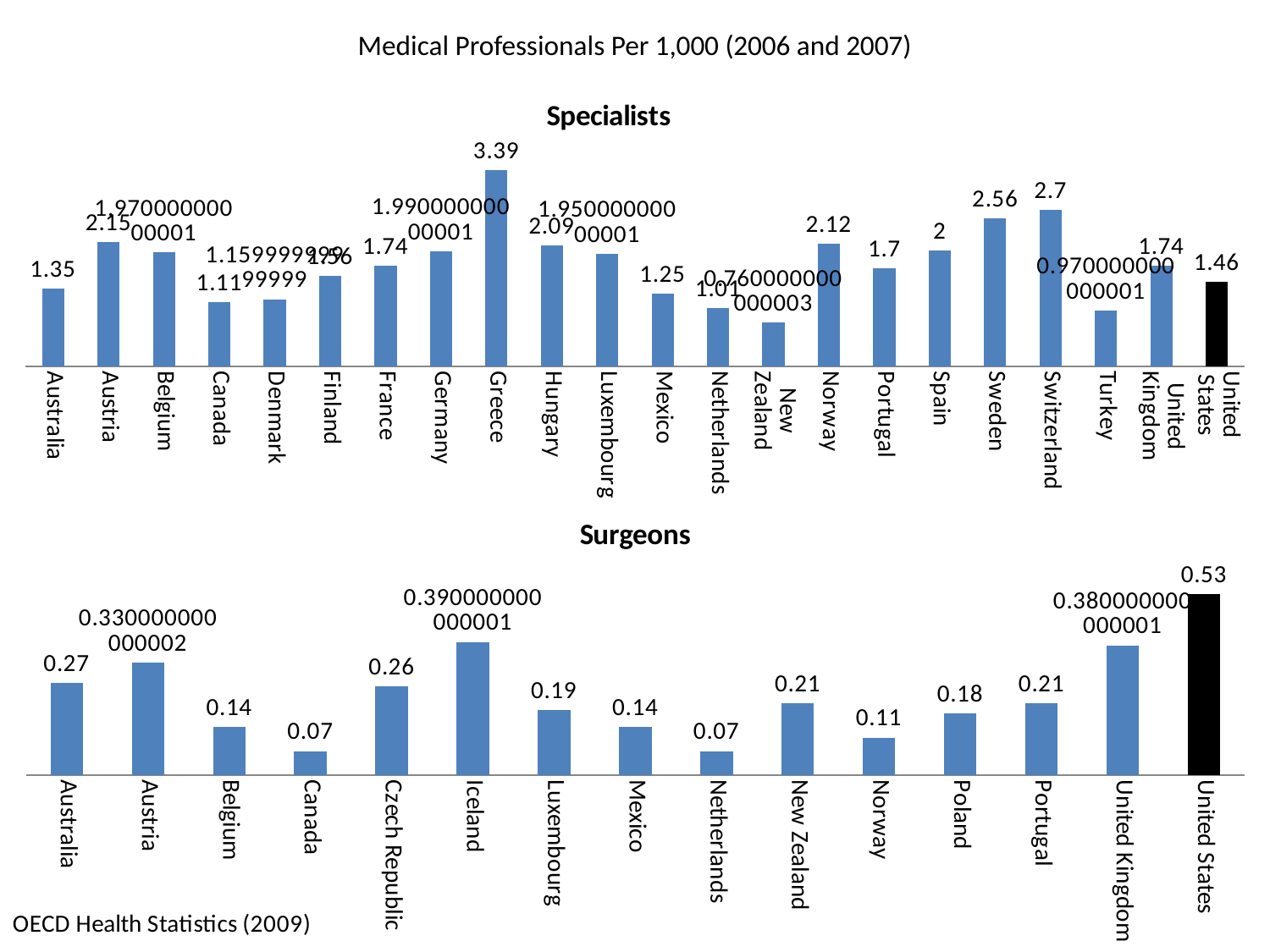
In the Specialists chart, what is the value for Greece? 3.39 How many countries are shown in the Surgeons chart? 15 In the Specialists chart, what is the value for the United States? 1.46 In the Specialists chart, which is larger, Norway or Portugal? Norway In the Specialists chart, what is the difference between Switzerland and Sweden? 0.14 In the Surgeons chart, what is the value for the United States? 0.53 In the Specialists chart, which country has the highest value? Greece In both charts, which country's bar is coloured black instead of blue? United States In the Surgeons chart, what is the value for Czech Republic? 0.26 In the Surgeons chart, what is the difference between Australia and Norway? 0.16 What type of chart is the Surgeons chart? Bar chart In the Surgeons chart, which country has the highest value? United States